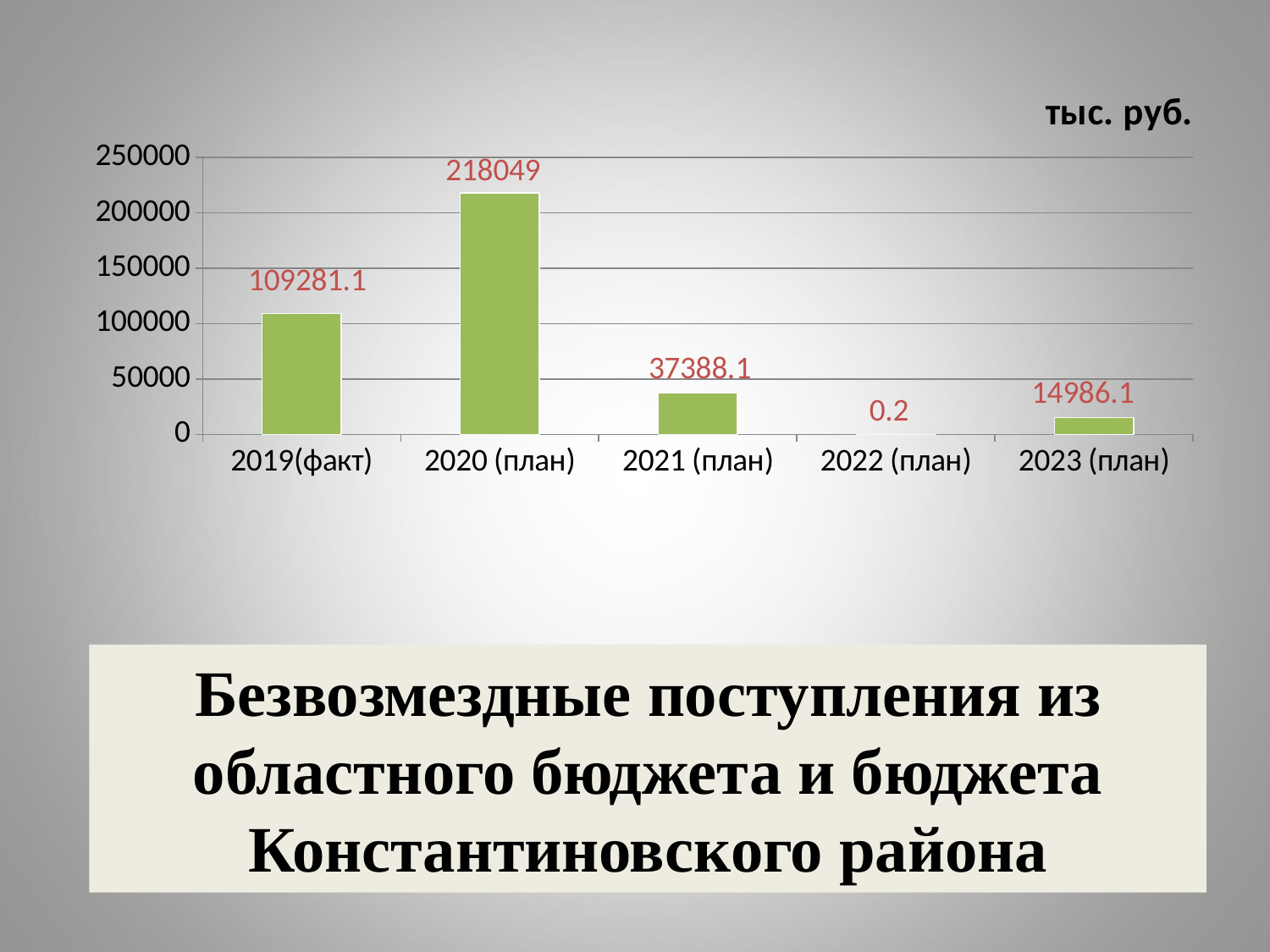
What is the difference between the values for 2020 (план) and 2019(факт)? 108767.9 What unit of measurement is indicated above the chart? тыс. руб. Which is larger, the value for 2021 (план) or the value for 2023 (план)? 2021 (план) What is the difference between the values for 2021 (план) and 2023 (план)? 22402 How many categories are shown on the x axis? 5 Which category has the highest value? 2020 (план) What is the value for 2022 (план)? 0.2 What is the value for 2023 (план)? 14986.1 What kind of chart is shown on the slide? Bar chart What is the value for 2020 (план)? 218049 Which category has the lowest value? 2022 (план) What is the value for 2019(факт)? 109281.1